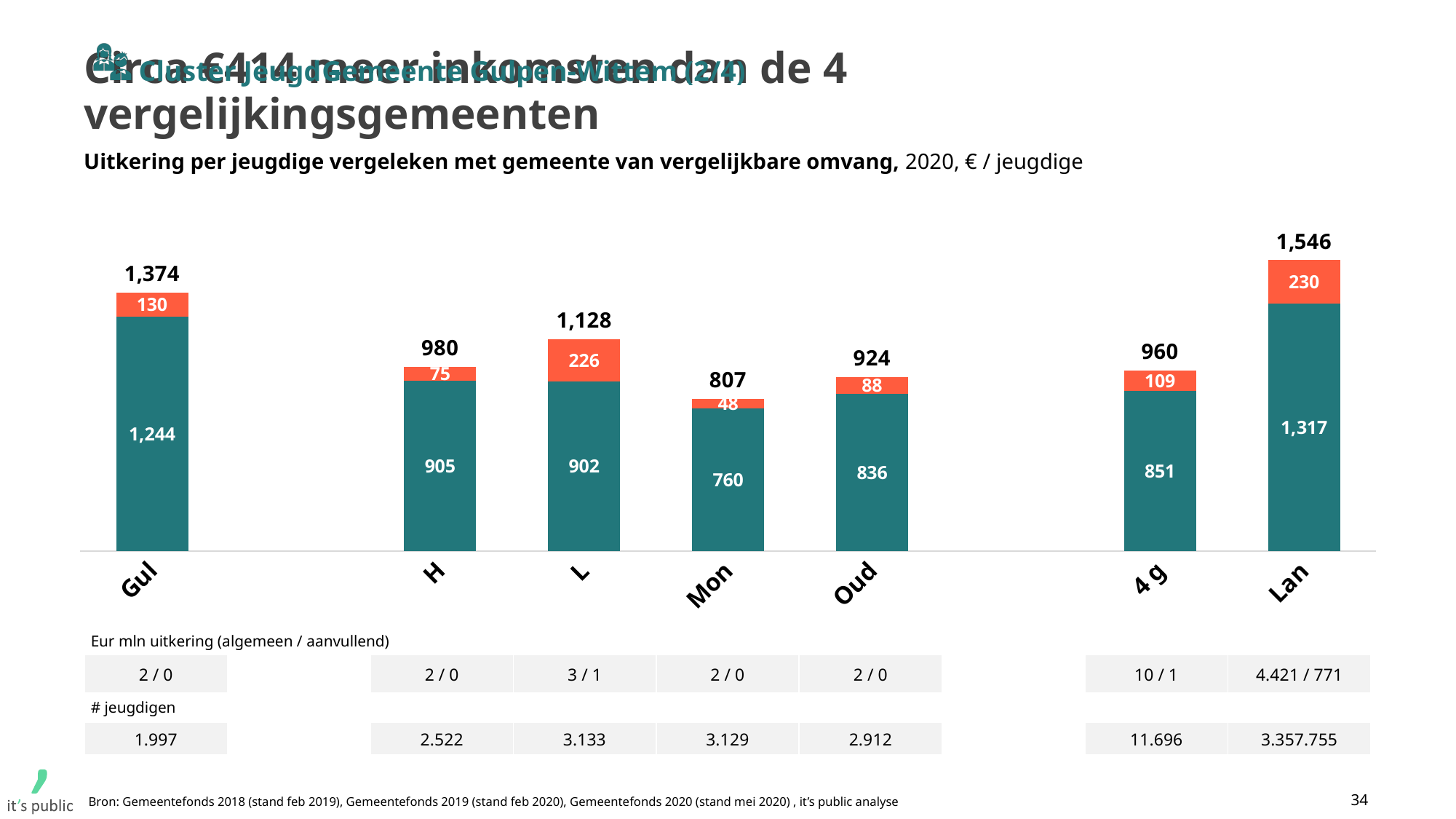
What is the total value shown above the bar for Gul? 1,374 What is the value of the orange (top) segment of the bar for L? 226 Which has a larger total value, Oud or 4 g? 4 g What is the total of the stacked bar for Oud? 924 Which category has the lowest total value? Mon What is the difference between the total for Gul and the total for H? 394 What is the value of the teal (bottom) segment of the bar for Lan? 1,317 What colour is the bottom segment of each stacked bar? Teal What is the total value shown above the bar for Mon? 807 Which category has the highest total value? Lan What kind of chart is shown on the slide? Stacked bar chart How many categories are shown on the x axis of the chart? 7